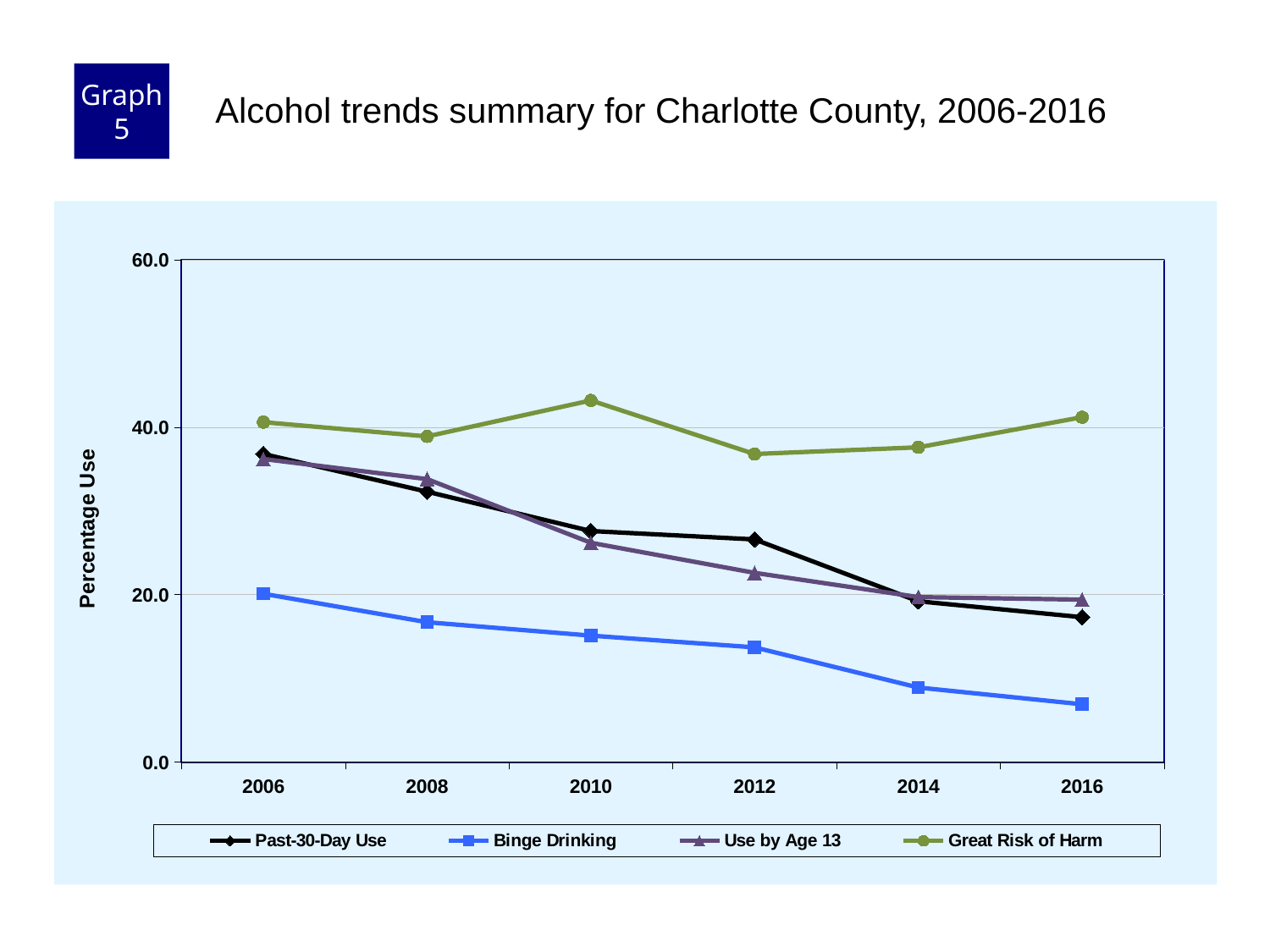
Does the Binge Drinking line rise or fall from 2006 to 2016? Falls What is the label on the y axis? Percentage Use How many series does the legend list? 4 What kind of chart is shown on the slide? Line chart Which series has the highest value in 2016? Great Risk of Harm In 2012, which is larger: Past-30-Day Use or Use by Age 13? Past-30-Day Use Which series has the lowest value in 2016? Binge Drinking How many years are plotted along the x axis? 6 Is the value for Binge Drinking in 2016 greater or less than 20.0? less Is the value for Great Risk of Harm in 2010 greater or less than 40.0? greater Does the Past-30-Day Use line rise or fall from 2006 to 2016? Falls Is the value for Great Risk of Harm in 2012 greater or less than 40.0? less